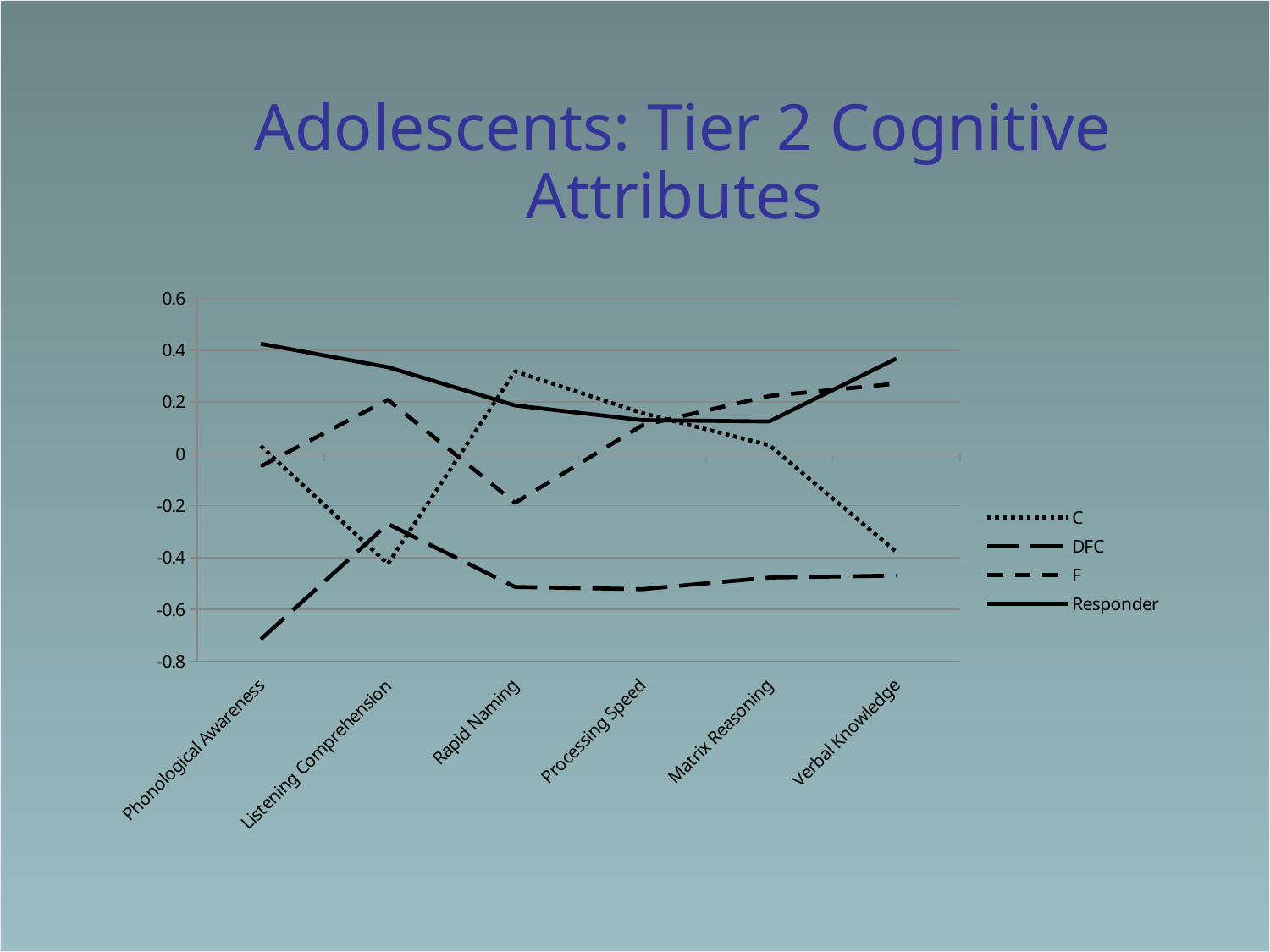
What kind of chart is shown on the slide? line chart Is the value for Responder at Phonological Awareness greater or less than 0.4? greater Is the value for DFC at Phonological Awareness greater or less than -0.6? less Which series is drawn with a solid line? Responder For the C series, which category has the highest value? Rapid Naming At Rapid Naming, which series has the larger value, C or F? C At Phonological Awareness, which series has the larger value, Responder or DFC? Responder For the DFC series, which category has the lowest value? Phonological Awareness How many categories are shown on the x axis? 6 Does the Responder series rise or fall from Phonological Awareness to Matrix Reasoning? fall How many series does the legend list? 4 Is the value for F at Rapid Naming greater or less than 0? less